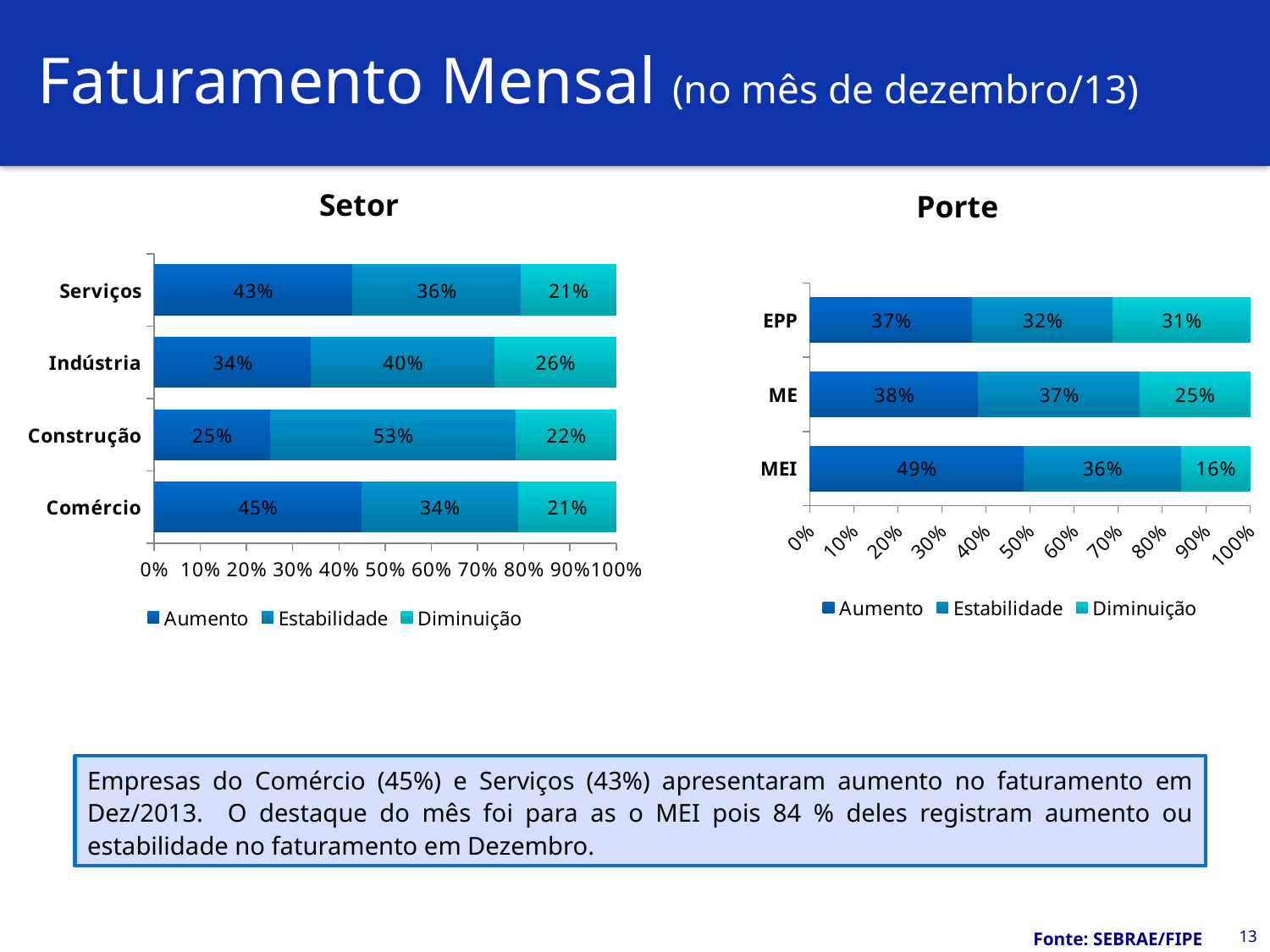
In the Porte chart, what is the Aumento value for EPP? 37% In the Setor chart, what is the Estabilidade value for Construção? 53% In the Setor chart, what is the Aumento value for Comércio? 45% In the Setor chart, what is the difference between the Estabilidade values for Construção and Comércio? 19% In the Setor chart, which category has the highest Aumento value? Comércio In the Porte chart, which is larger: the Aumento value for MEI or the Aumento value for ME? MEI In the Setor chart, what is the total of the Indústria bar? 100% What kind of chart is the Porte chart? Stacked bar chart In the Porte chart, what is the Diminuição value for MEI? 16% In the Porte chart, which category has the lowest Diminuição value? MEI How many categories are shown in the Setor chart? 4 How many series does the legend of the Porte chart list? 3